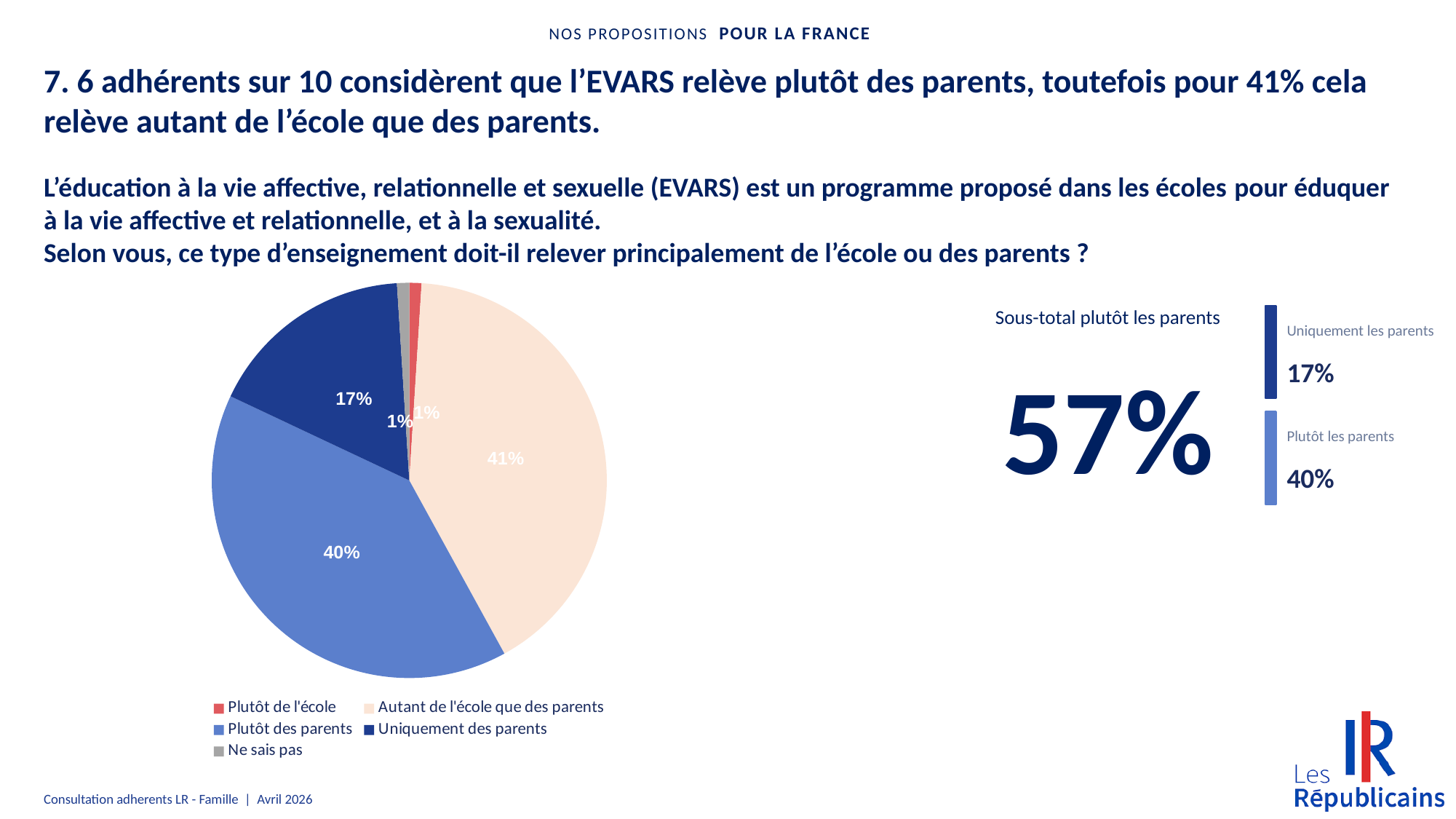
What is the "Sous-total plutôt les parents" shown to the right of the pie chart? 57% What share of respondents answered "Plutôt de l'école"? 1% What colour is the "Plutôt de l'école" slice in the pie chart? red What is the combined share of "Plutôt des parents" and "Uniquement des parents"? 57% Which category has the largest slice of the pie? Autant de l'école que des parents What share of respondents answered "Plutôt des parents"? 40% What share of respondents answered "Autant de l'école que des parents"? 41% What type of chart is shown on the slide? pie chart Which is larger: the share for "Uniquement des parents" or the share for "Ne sais pas"? Uniquement des parents How many categories does the legend of the pie chart list? 5 What share of respondents answered "Uniquement des parents"? 17% What is the difference between the "Plutôt des parents" share and the "Uniquement des parents" share? 23 percentage points